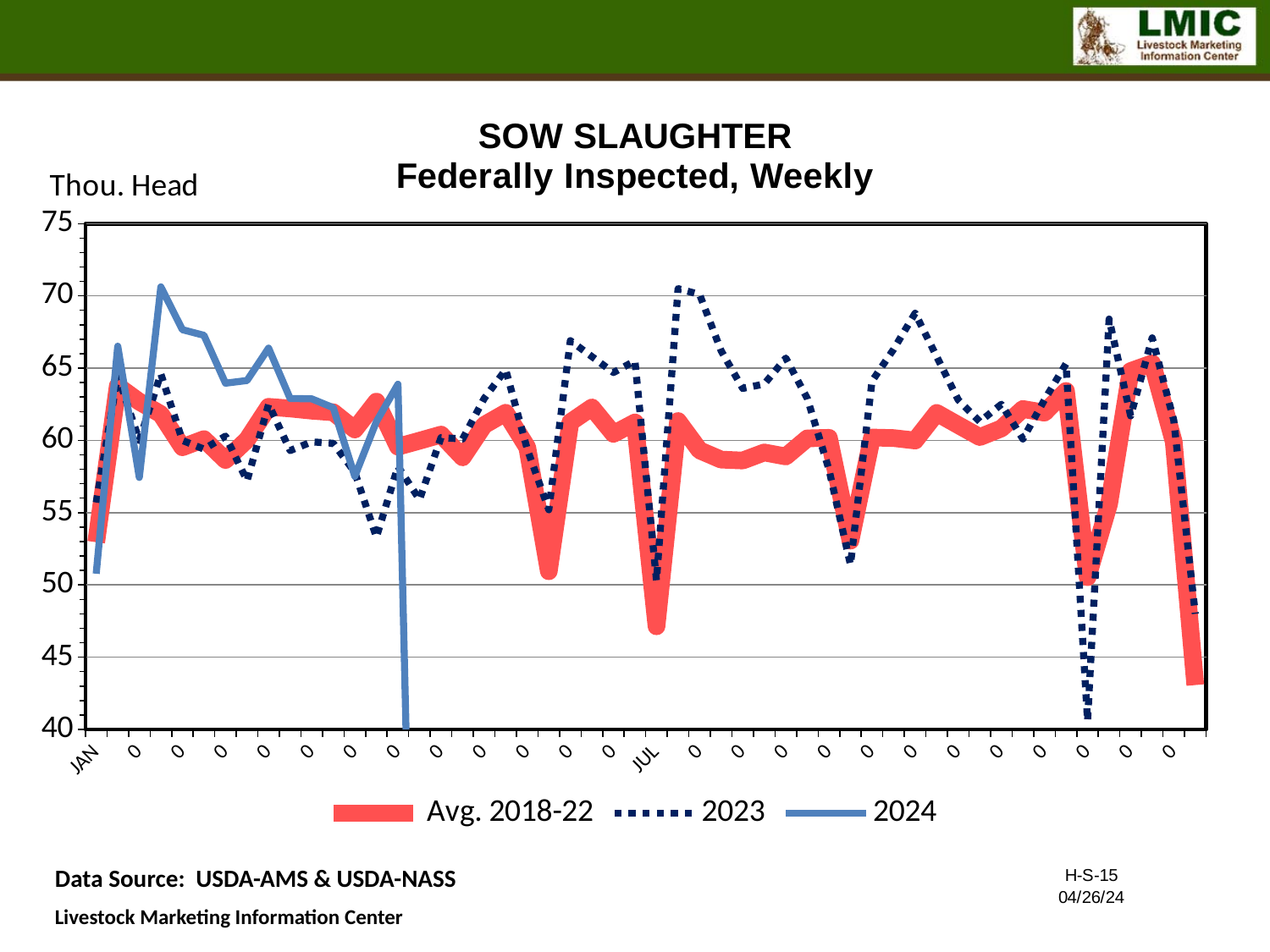
Is the highest point of the 2023 line greater or less than 65? greater What unit is shown on the y axis of the chart? Thou. Head Is the value of the Avg. 2018-22 line at the far right end of the chart greater or less than 45? less Over the final weeks of the year, does the Avg. 2018-22 line rise or fall? fall Is the lowest point of the 2023 line greater or less than 45? less In the early weeks of the year, which series reaches a higher peak: 2024 or 2023? 2024 What kind of chart is shown on the slide? line chart How many series does the legend list? 3 What are the three series listed in the legend? Avg. 2018-22, 2023, 2024